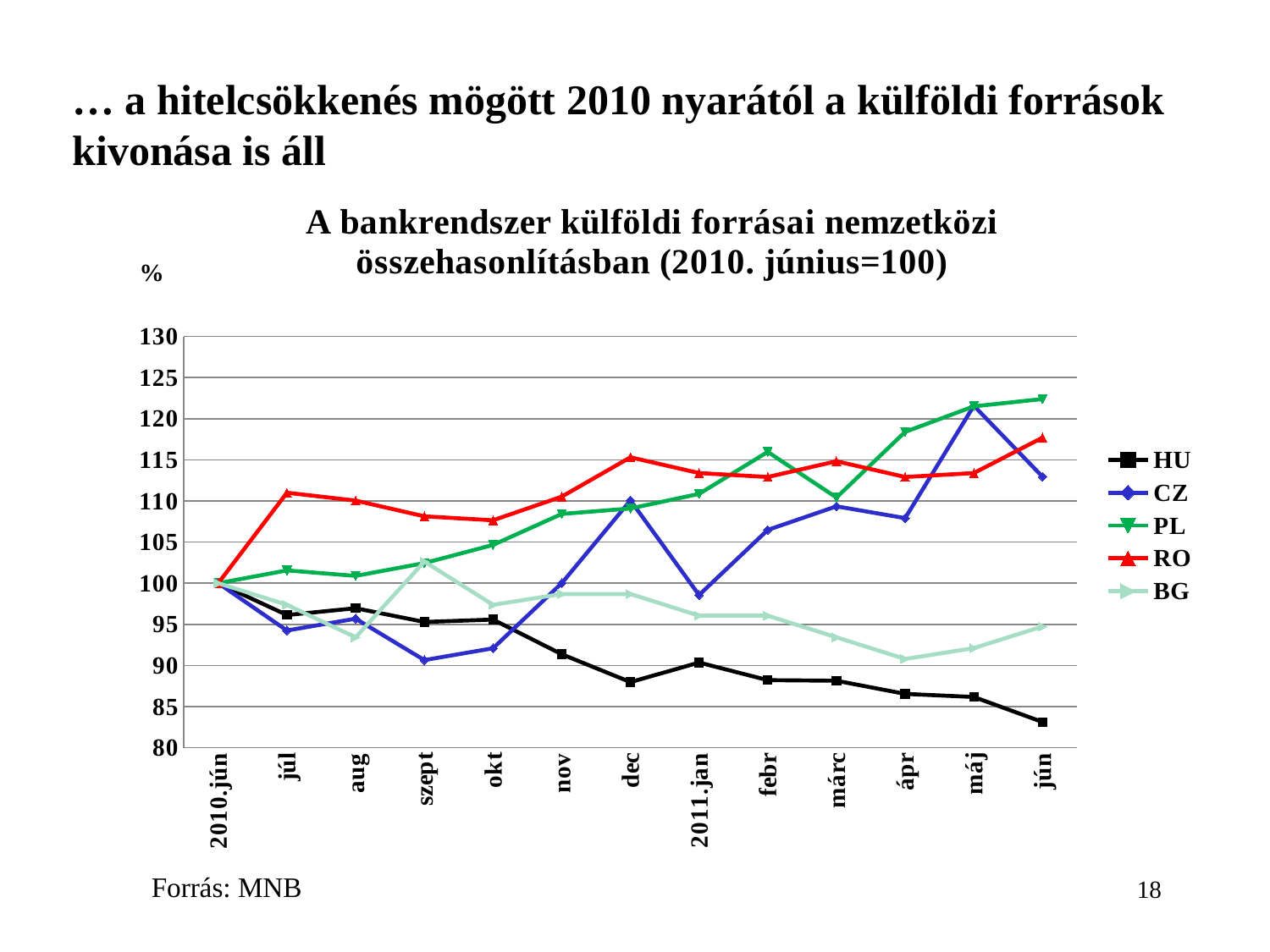
How many points are plotted along the x axis for each series? 13 What is the value of every series at 2010.jún, the base period? 100 Is the value for HU in jún (2011) greater or less than 85? less How many series does the legend list? 5 Is the value for BG in ápr greater or less than 95? less Which series are listed in the legend? HU, CZ, PL, RO, BG Does the HU series generally rise or fall from 2010.jún to jún 2011? fall What kind of chart is shown on the slide? line chart Which series has the lowest value in jún (2011)? HU In dec, which series has the larger value, RO or HU? RO Is the value for PL in jún (2011) greater or less than 120? greater Which series has the highest value in jún (2011)? PL